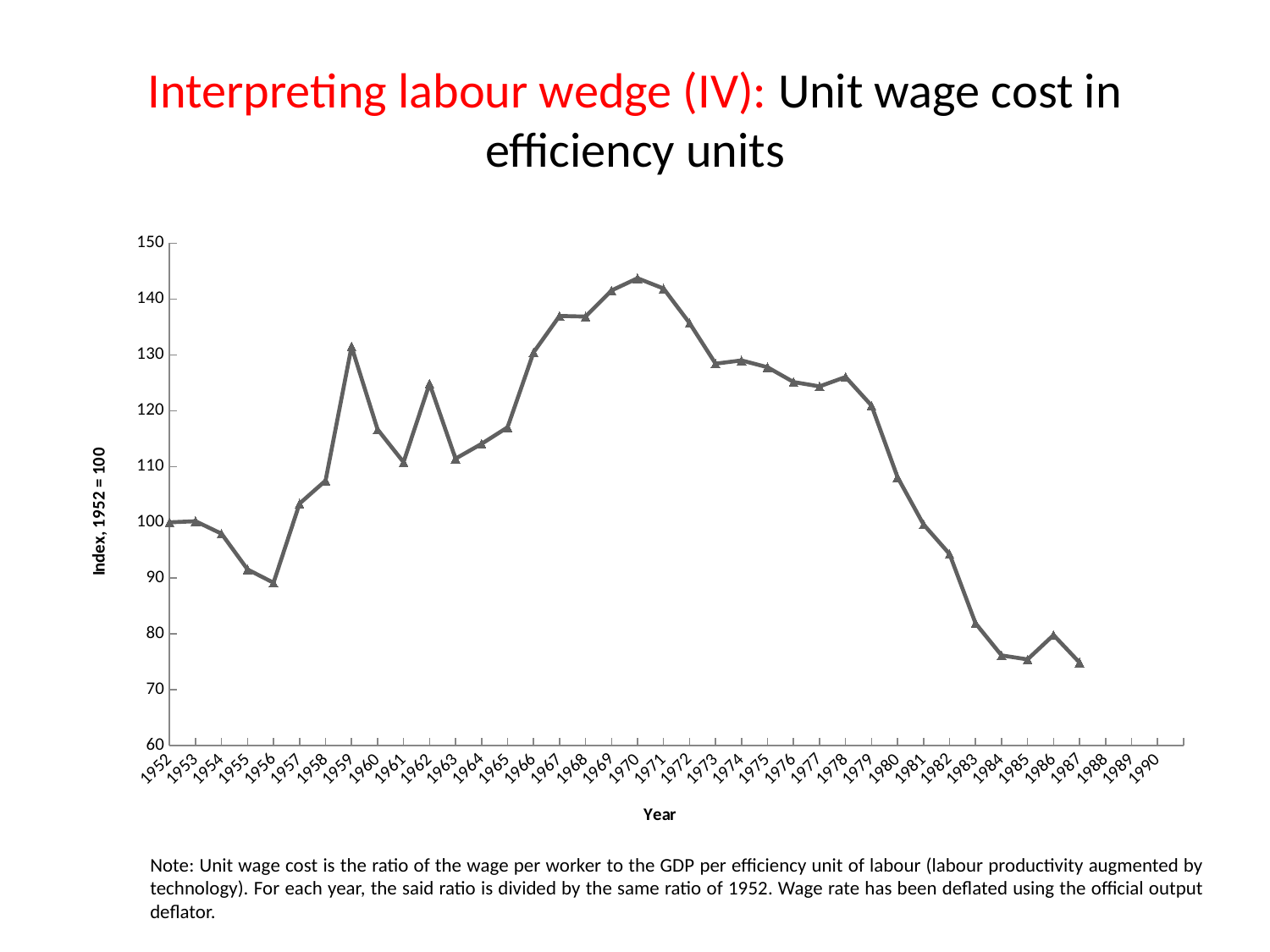
Is the value for 1983 greater or less than 90? less In which year does the unit wage cost index reach its highest value? 1970 Is the value for 1955 greater or less than 100? less What is the value of the index for 1952? 100 Which year has the higher value, 1959 or 1962? 1959 What kind of chart is shown on the slide? line chart What is the title of the vertical axis? Index, 1952 = 100 Which year has the higher value, 1953 or 1986? 1953 Is the value for 1987 greater or less than 80? less Do the values rise or fall between 1970 and 1987? fall